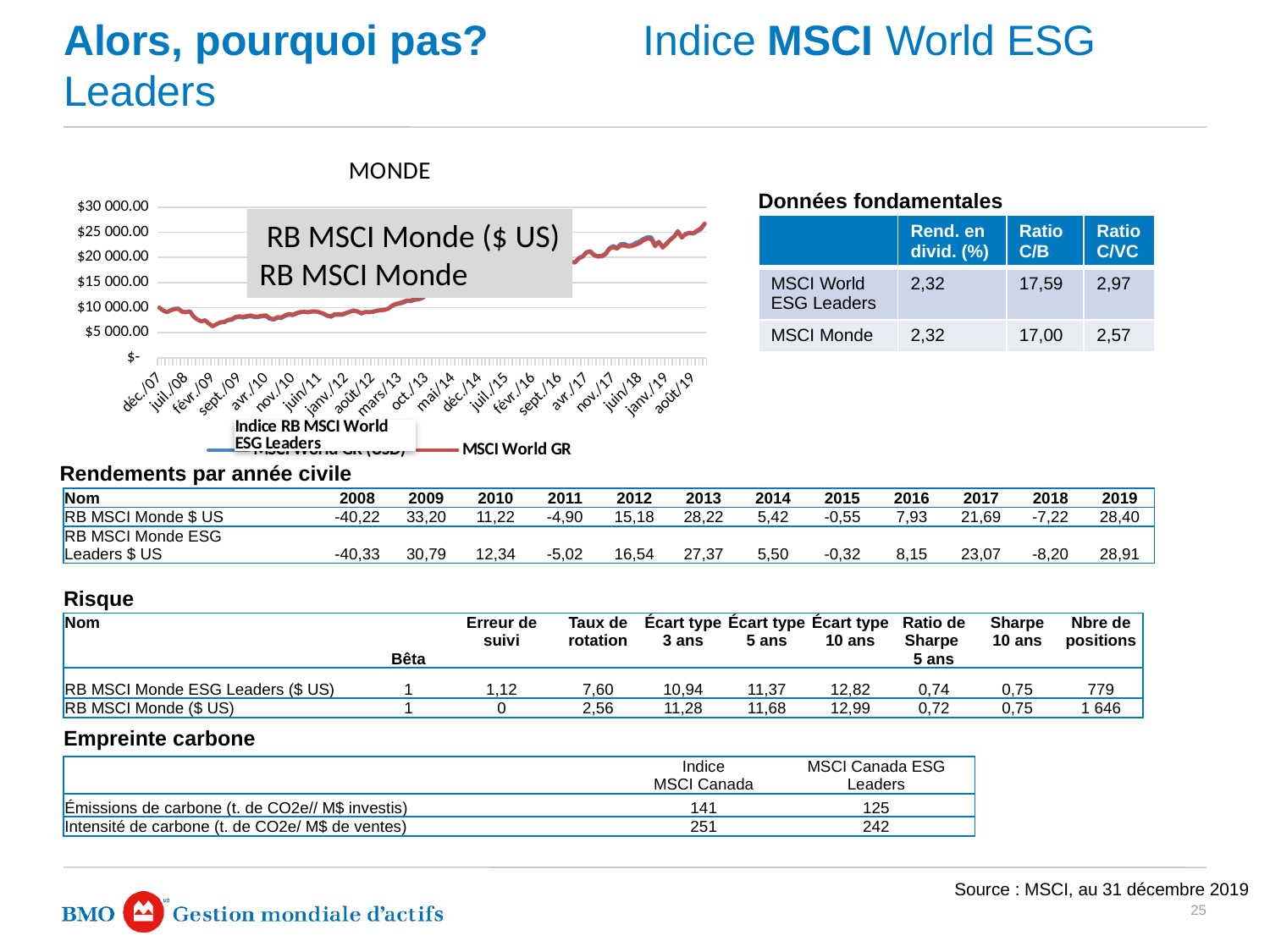
What is the highest tick label shown on the vertical axis of the MONDE chart? $30 000.00 In the MONDE chart, is the value of the lines around févr./09 greater or less than $10 000.00? less In the MONDE chart, is the value of the lines at août/19 greater or less than $30 000.00? less How many series does the legend of the MONDE chart list? 2 What kind of chart is shown under the title "MONDE"? line chart In the MONDE chart, is the value of the lines around juil./15 greater or less than $15 000.00? greater In the MONDE chart, do the index values overall rise or fall from déc./07 to août/19? rise What is the title of the chart on the left of the slide? MONDE